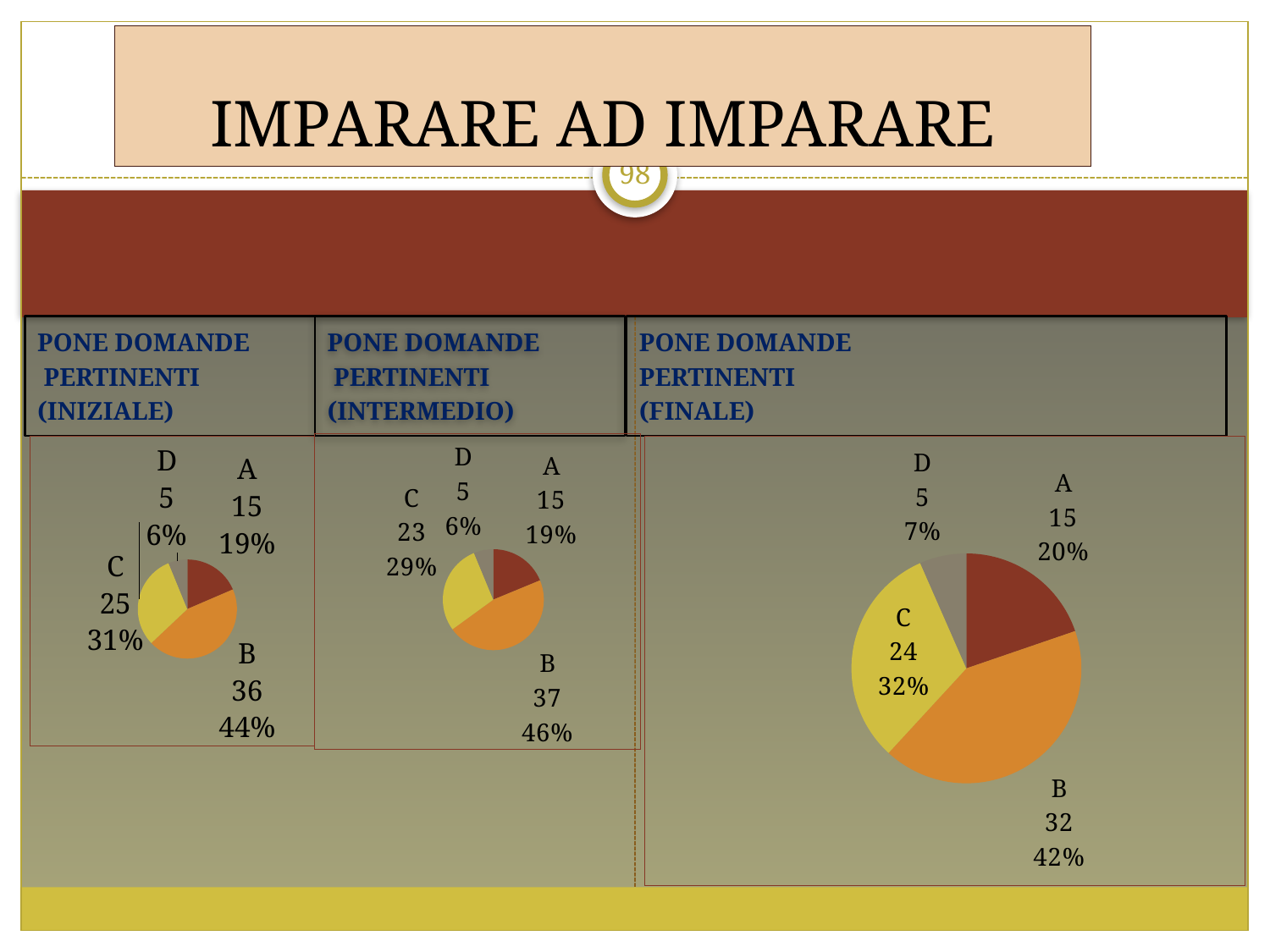
In the PONE DOMANDE PERTINENTI (FINALE) chart, what percentage share does D have? 7% In the PONE DOMANDE PERTINENTI (INTERMEDIO) chart, what is the value for C? 23 In the PONE DOMANDE PERTINENTI (FINALE) chart, what is the value for B? 32 In the PONE DOMANDE PERTINENTI (INTERMEDIO) chart, what percentage share does B have? 46% In the PONE DOMANDE PERTINENTI (INTERMEDIO) chart, what is the difference between the values for B and C? 14 In the PONE DOMANDE PERTINENTI (INIZIALE) chart, what is the value for B? 36 How many categories are shown in the PONE DOMANDE PERTINENTI (INIZIALE) chart? 4 In the PONE DOMANDE PERTINENTI (FINALE) chart, which category has the largest slice? B What kind of chart is the PONE DOMANDE PERTINENTI (FINALE) chart? Pie chart In the PONE DOMANDE PERTINENTI (INIZIALE) chart, what percentage share does C have? 31% In the PONE DOMANDE PERTINENTI (INIZIALE) chart, which category has the smallest slice? D In the PONE DOMANDE PERTINENTI (FINALE) chart, which is larger, the value for C or the value for A? C